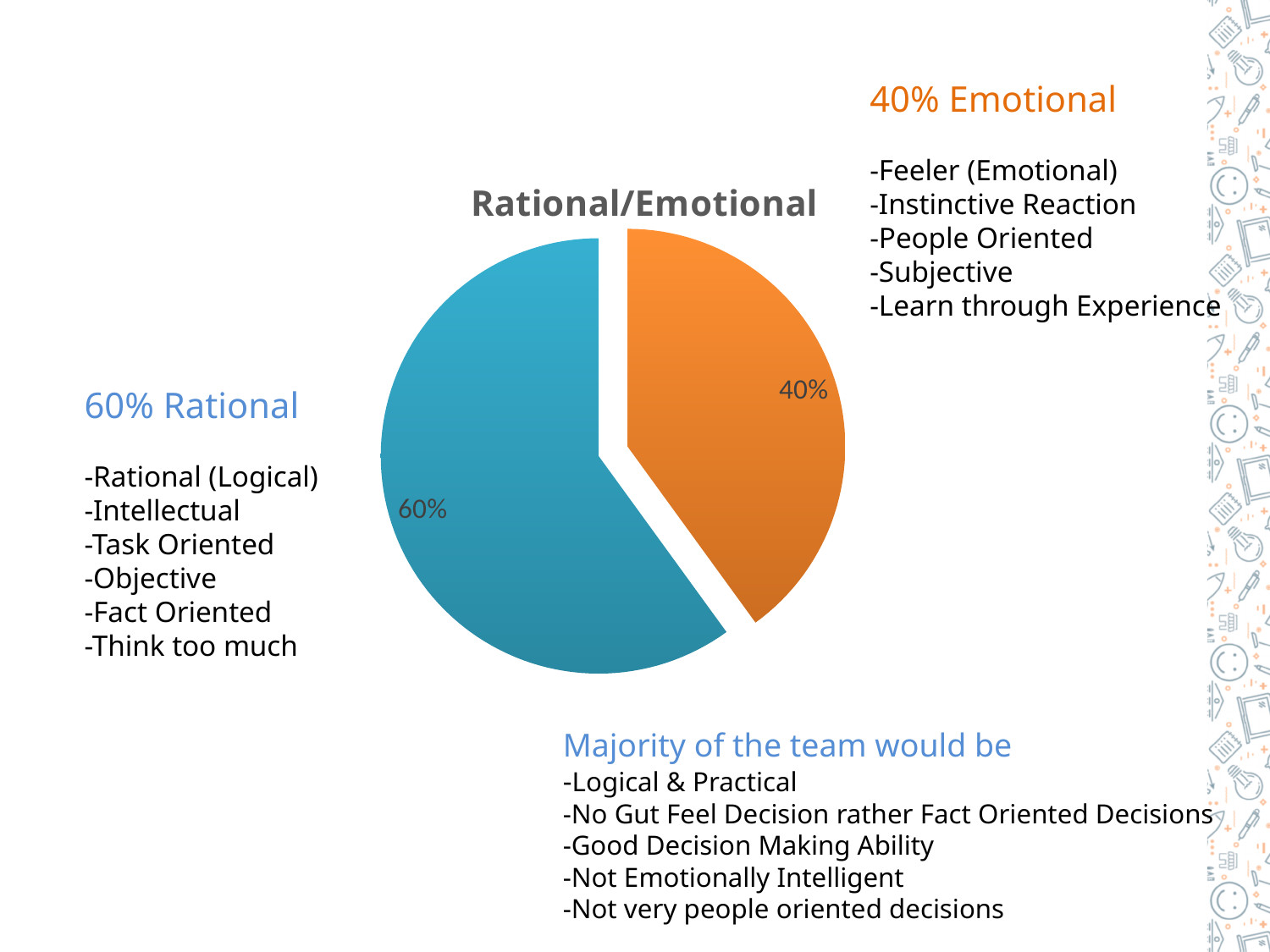
Is the Rational slice greater or less than 50% of the pie? greater What colour is the Emotional slice of the pie chart? orange What is the title of the chart? Rational/Emotional What type of chart is shown on the slide? pie chart How many slices does the pie chart have? 2 What percentage of the pie chart is Emotional? 40% Which slice of the pie chart is the largest? Rational Which is larger, the Rational slice or the Emotional slice? Rational Which slice of the pie chart is the smallest? Emotional What percentage of the pie chart is Rational? 60% What is the difference in percentage points between the Rational and Emotional slices? 20%